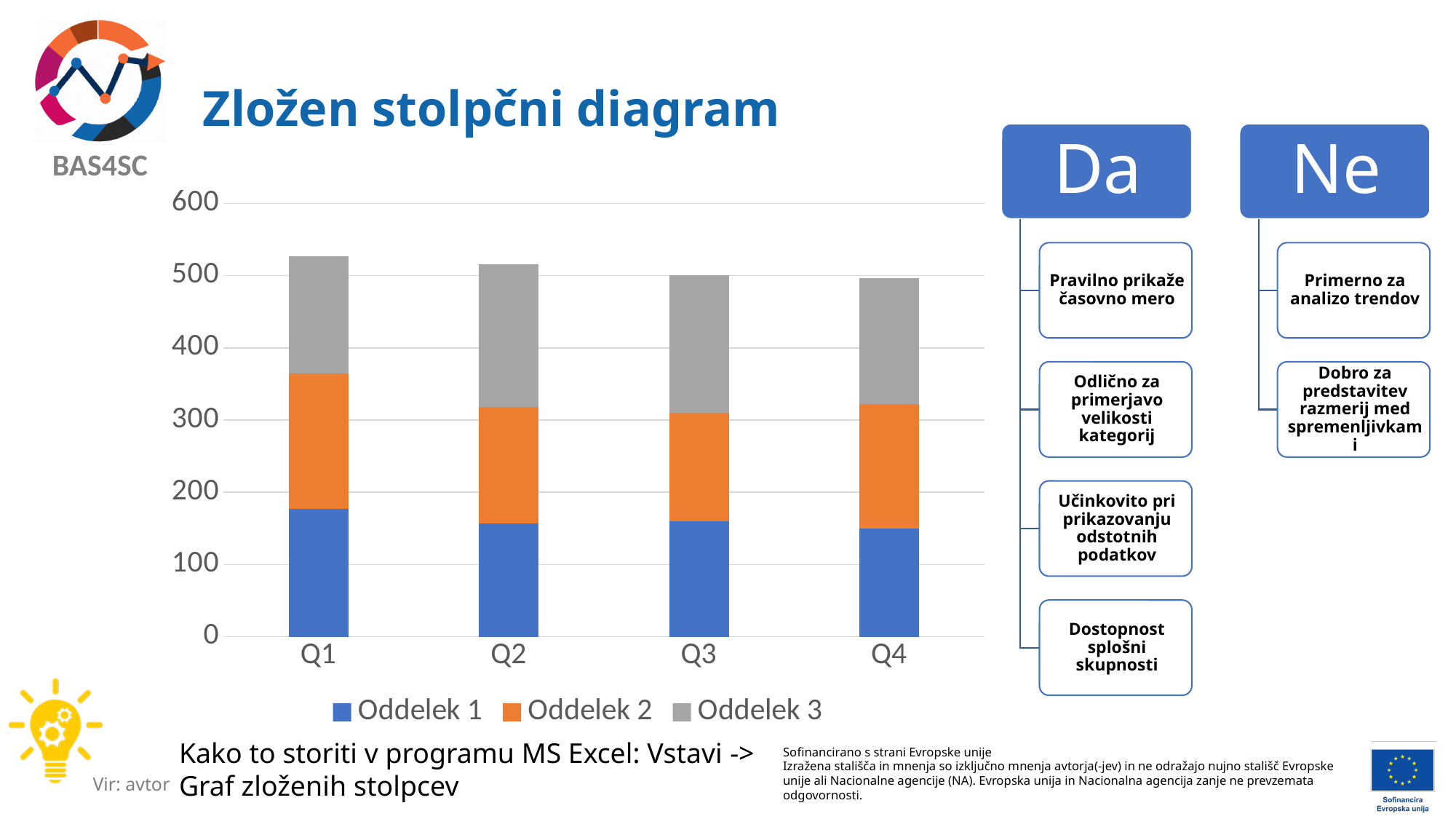
What kind of chart is shown on the slide? stacked bar chart How many categories are shown on the x axis of the chart? 4 What is the title of the slide containing the chart? Zložen stolpčni diagram Which is larger: the value for Oddelek 1 in Q1 or the value for Oddelek 1 in Q4? Q1 Do the total stacked values rise or fall from Q1 to Q4? fall Is the total stacked value for Q4 greater or less than 600? less Is the total stacked value for Q2 greater or less than 400? greater Is the total stacked value for Q1 greater or less than 500? greater Which series is shown in orange in the chart? Oddelek 2 How many series does the chart legend list? 3